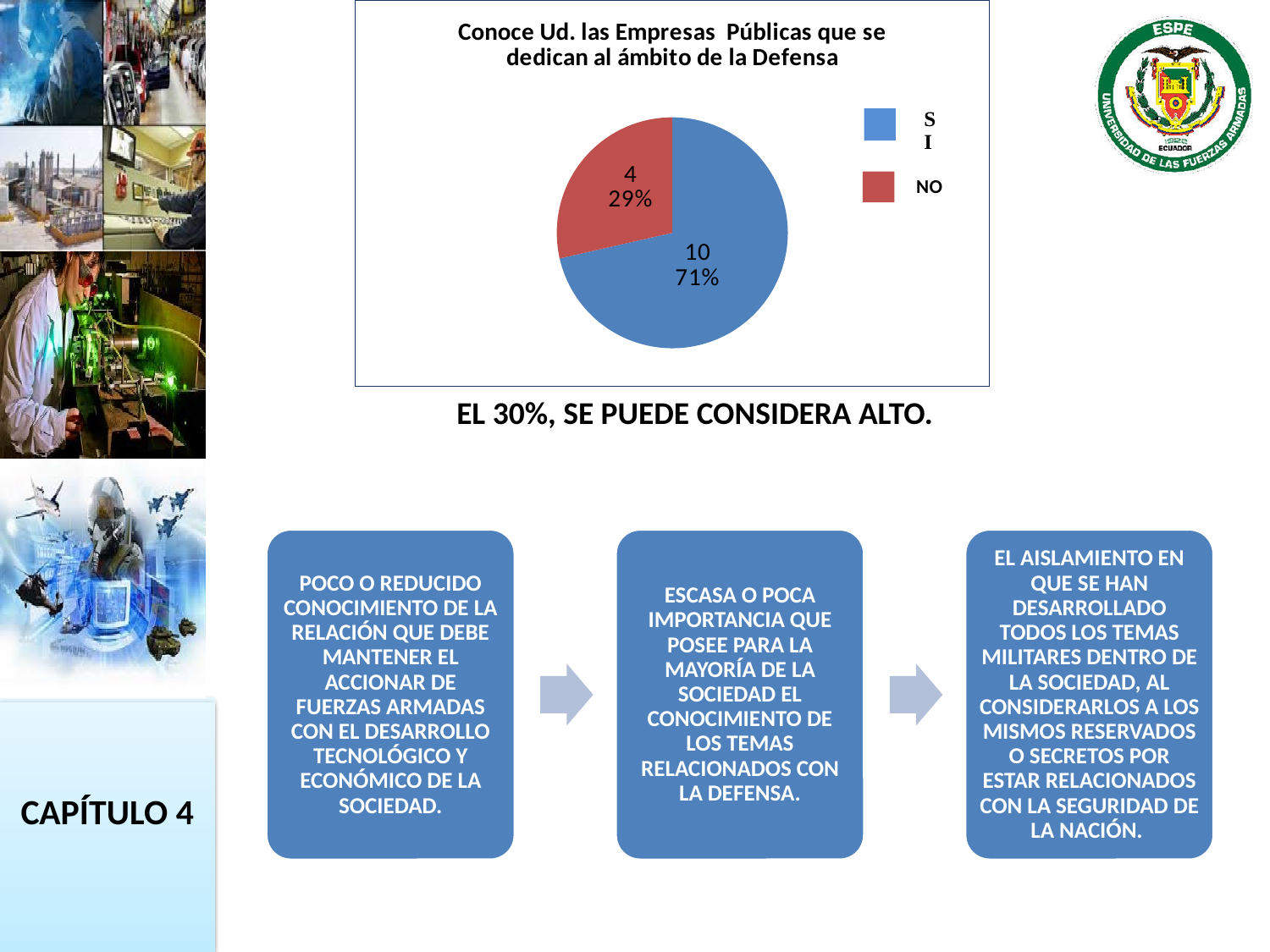
How many entries does the legend list? 2 What kind of chart is shown on the slide? pie chart Which colour represents the NO slice? red What is the difference between the SI count and the NO count? 6 What count is shown for the SI slice? 10 What is the title of the chart? Conoce Ud. las Empresas Públicas que se dedican al ámbito de la Defensa What percentage share does the NO slice have? 29% Which slice is the smallest? NO What percentage share does the SI slice have? 71% How many slices does the pie chart have? 2 Which slice is the largest? SI What count is shown for the NO slice? 4